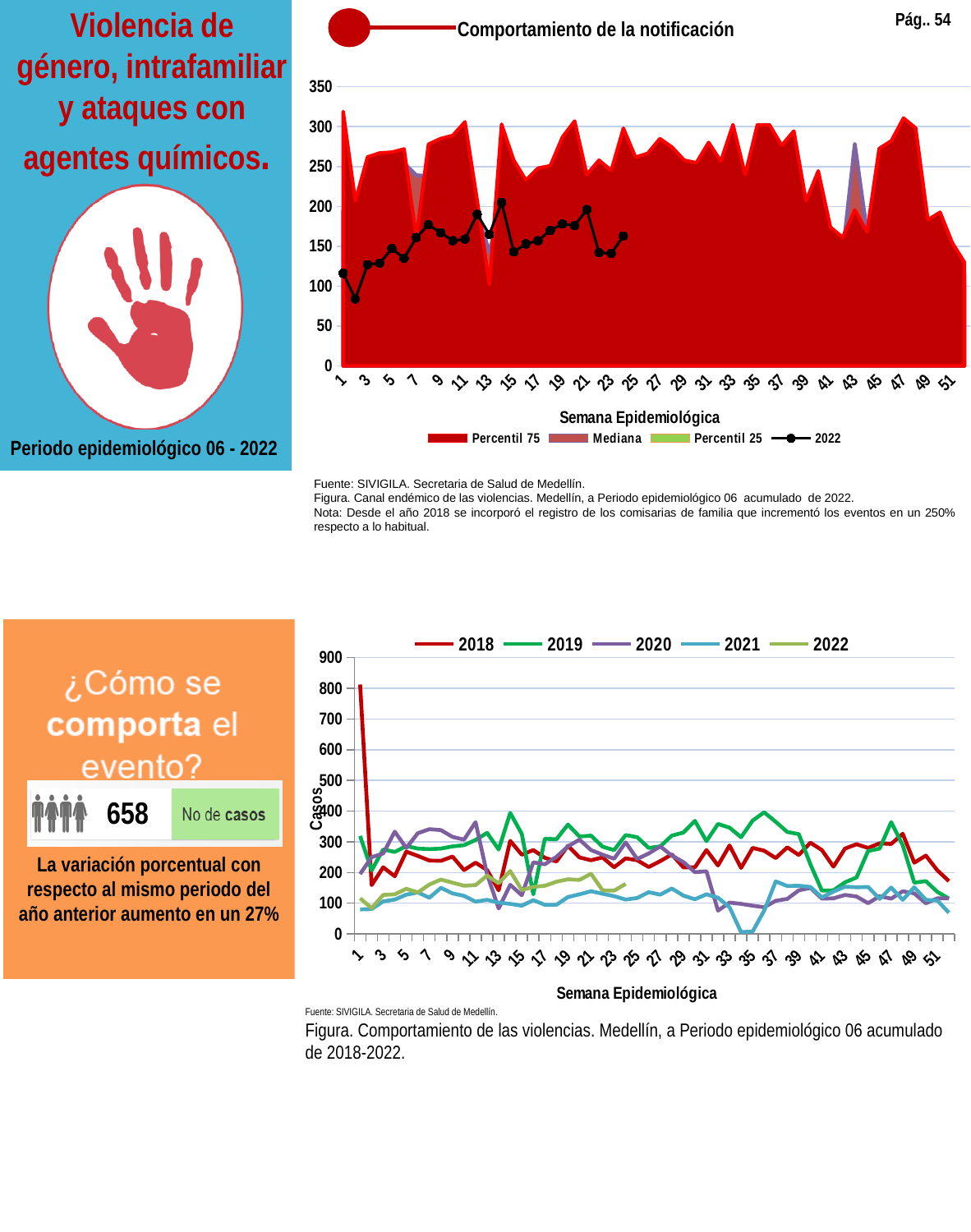
In the bottom chart, what is the title of the vertical axis? Casos In the top chart titled 'Comportamiento de la notificación', at week 1, which is larger: the value for Percentil 75 or the value for 2022? Percentil 75 In the top chart titled 'Comportamiento de la notificación', how many series does the legend list? 4 In the bottom chart, is the value for 2019 at week 36 greater or less than 300? greater In the top chart titled 'Comportamiento de la notificación', is the value for Percentil 75 at week 1 greater or less than 300? greater What kind of chart is the bottom chart? Line chart In the bottom chart, how many series does the legend list? 5 In the bottom chart, which years are listed in the legend? 2018, 2019, 2020, 2021, 2022 In the top chart titled 'Comportamiento de la notificación', is the value for 2022 at week 2 greater or less than 100? less In the bottom chart, at week 1, which is larger: the value for 2018 or the value for 2021? 2018